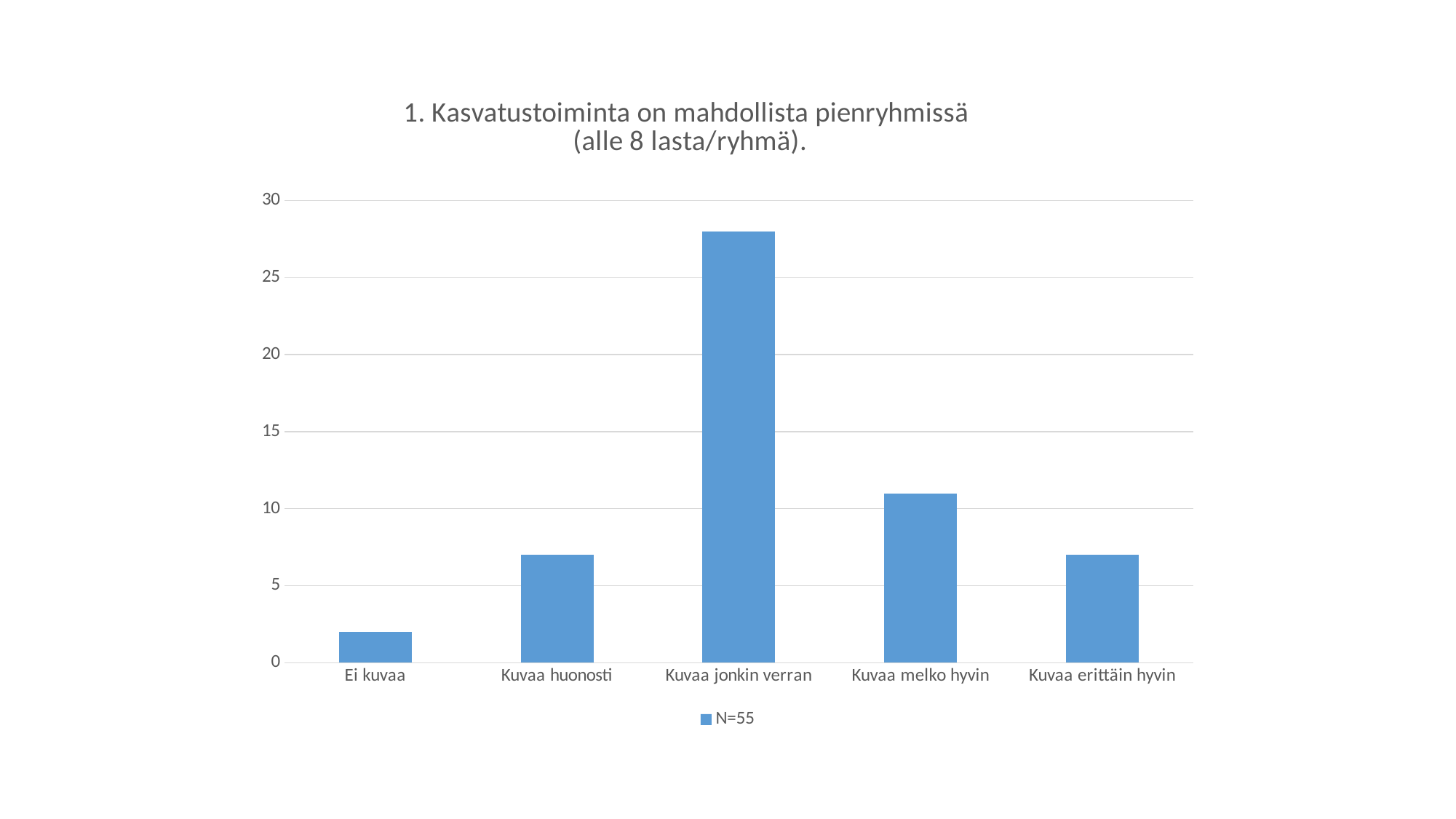
Which category has the highest bar? Kuvaa jonkin verran Is the value for Ei kuvaa greater or less than 5? less Which category has the lowest bar? Ei kuvaa Is the value for Kuvaa jonkin verran greater or less than 25? greater How many series does the legend list? 1 Is the value for Kuvaa huonosti greater or less than 10? less Which is larger, the value for Kuvaa melko hyvin or the value for Kuvaa erittäin hyvin? Kuvaa melko hyvin What is the legend entry for the series? N=55 How many categories are shown on the x axis? 5 What is the title of the chart? 1. Kasvatustoiminta on mahdollista pienryhmissä (alle 8 lasta/ryhmä). What kind of chart is shown on the slide? bar chart